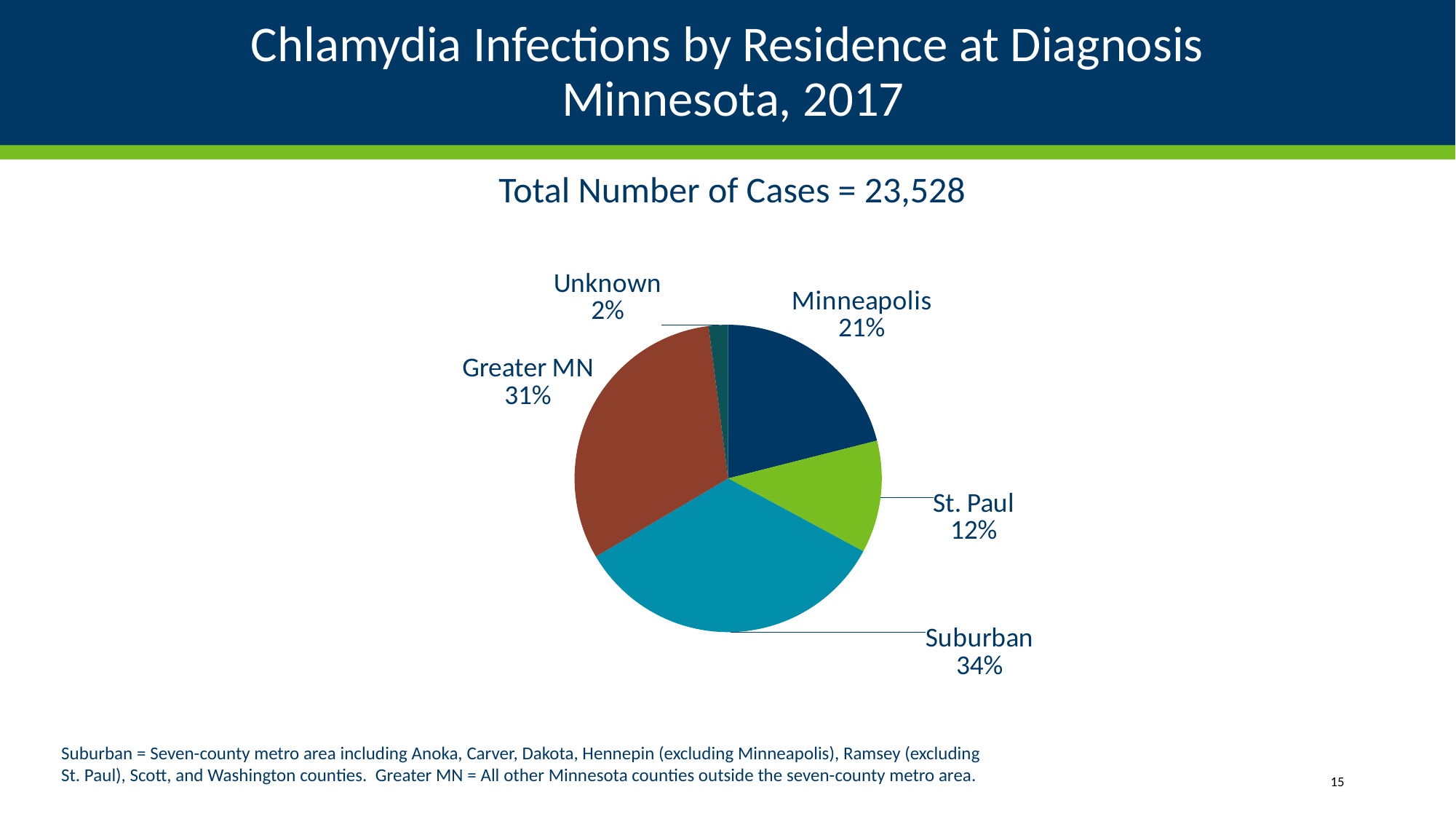
Which has a larger share of cases, Minneapolis or St. Paul? Minneapolis What is the difference in percentage points between Minneapolis and St. Paul? 9 What percentage of cases is shown for Greater MN? 31% Which residence category has the smallest share of cases? Unknown How many residence categories are shown in the pie chart? 5 What kind of chart is shown on the slide? Pie chart What percentage of cases is shown for Minneapolis? 21% Which residence category has the largest share of cases? Suburban What is the total number of cases stated on the slide? 23,528 What percentage of cases is shown for St. Paul? 12% What is the difference in percentage points between Suburban and Greater MN? 3 What share of chlamydia infections is attributed to Suburban residence at diagnosis? 34%